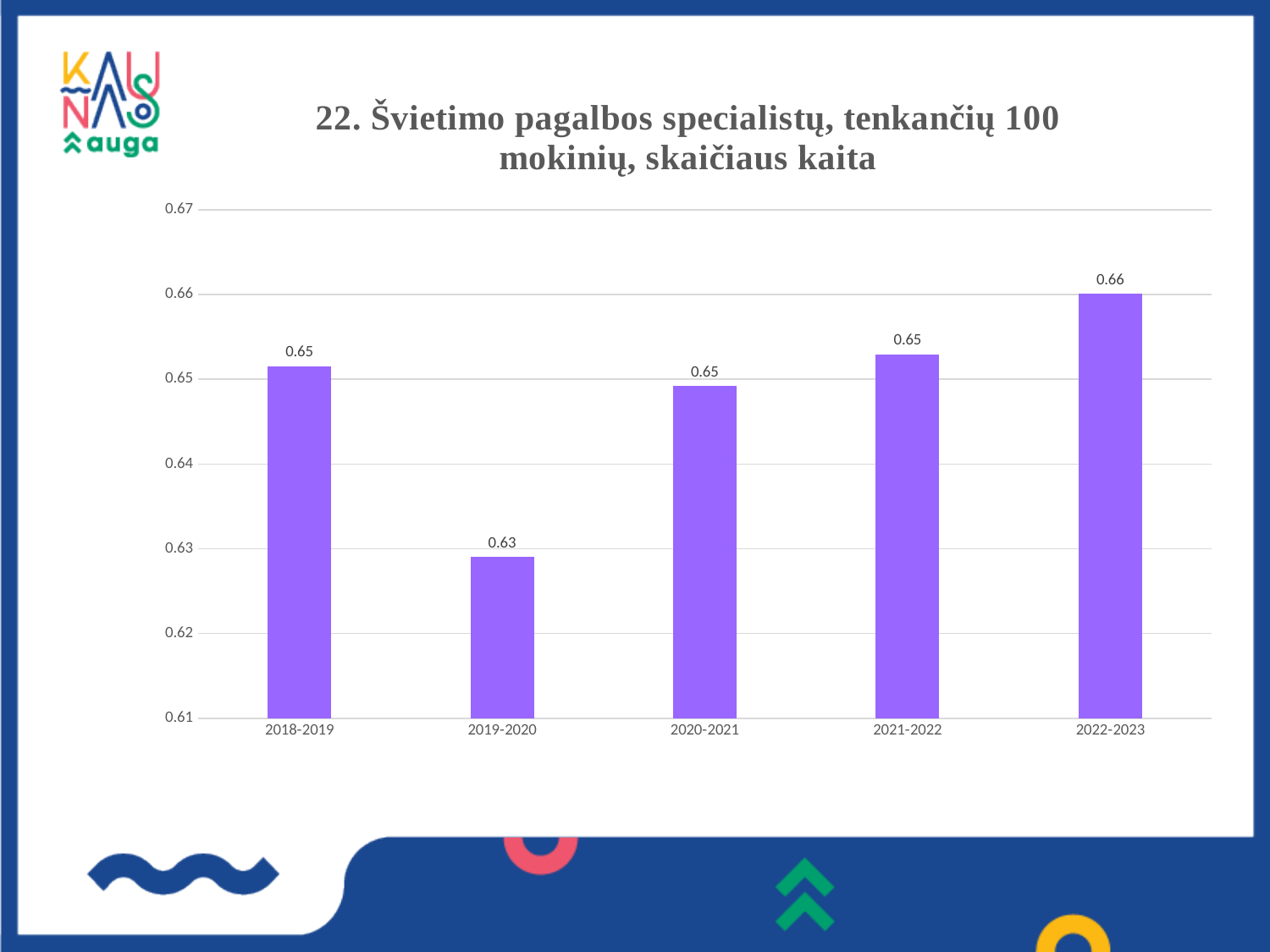
Is the value for 2019-2020 greater or less than 0.64? less What is the value for 2018-2019? 0.65 What is the difference between the values for 2022-2023 and 2019-2020? 0.03 How many school years are shown on the x axis? 5 From 2019-2020 to 2022-2023, do the values rise or fall? rise What kind of chart is shown on the slide? bar chart What is the value for 2019-2020? 0.63 What is the value for 2022-2023? 0.66 Which is larger, the value for 2019-2020 or the value for 2021-2022? 2021-2022 Is the value for 2022-2023 greater or less than 0.65? greater Which school year has the lowest value? 2019-2020 Which school year has the highest value? 2022-2023